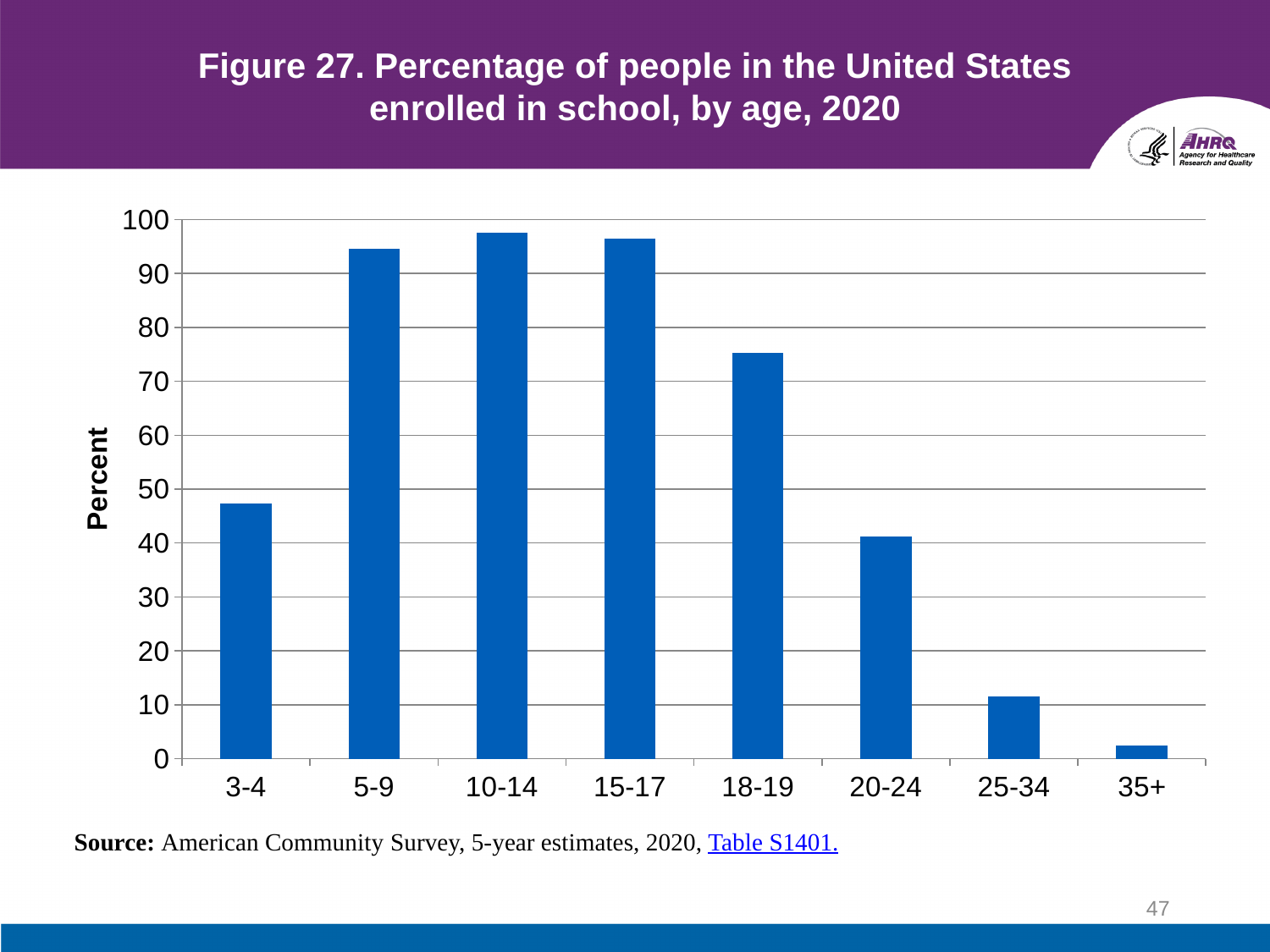
What is the label on the y axis of the chart? Percent Is the value for the 35+ age group greater or less than 10? less Is the value for the 20-24 age group greater or less than 50? less What type of chart is shown on the slide? bar chart Is the value for the 3-4 age group greater or less than 50? less Which has a higher percentage enrolled in school, the 3-4 age group or the 20-24 age group? 3-4 Which has a higher percentage enrolled in school, the 18-19 age group or the 5-9 age group? 5-9 Which age group has the lowest percentage enrolled in school? 35+ How many age groups are shown on the x axis? 8